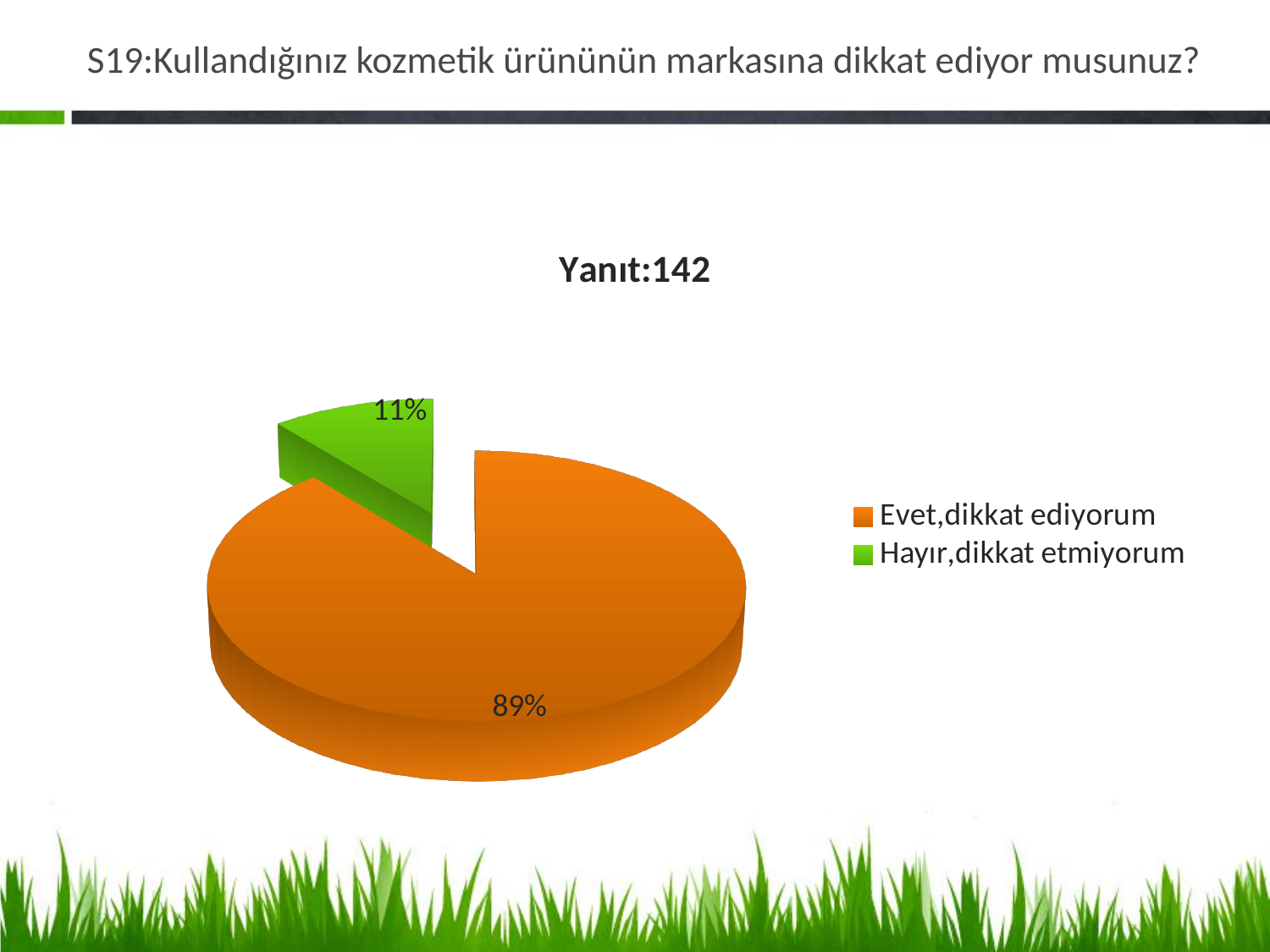
What is the chart's title? Yanıt:142 Which category has the largest slice of the pie? Evet,dikkat ediyorum What percentage of the pie is labelled "Hayır,dikkat etmiyorum"? 11% What is the difference in percentage points between the "Evet,dikkat ediyorum" slice and the "Hayır,dikkat etmiyorum" slice? 78 What percentage of the pie is labelled "Evet,dikkat ediyorum"? 89% Which category has the smallest slice of the pie? Hayır,dikkat etmiyorum How many slices does the pie chart have? 2 What share of the pie does the "Hayır,dikkat etmiyorum" slice take? 11% What kind of chart is shown on the slide? pie chart Which is larger: the "Evet,dikkat ediyorum" slice or the "Hayır,dikkat etmiyorum" slice? Evet,dikkat ediyorum How many entries does the legend list? 2 What colour is the "Hayır,dikkat etmiyorum" slice? green